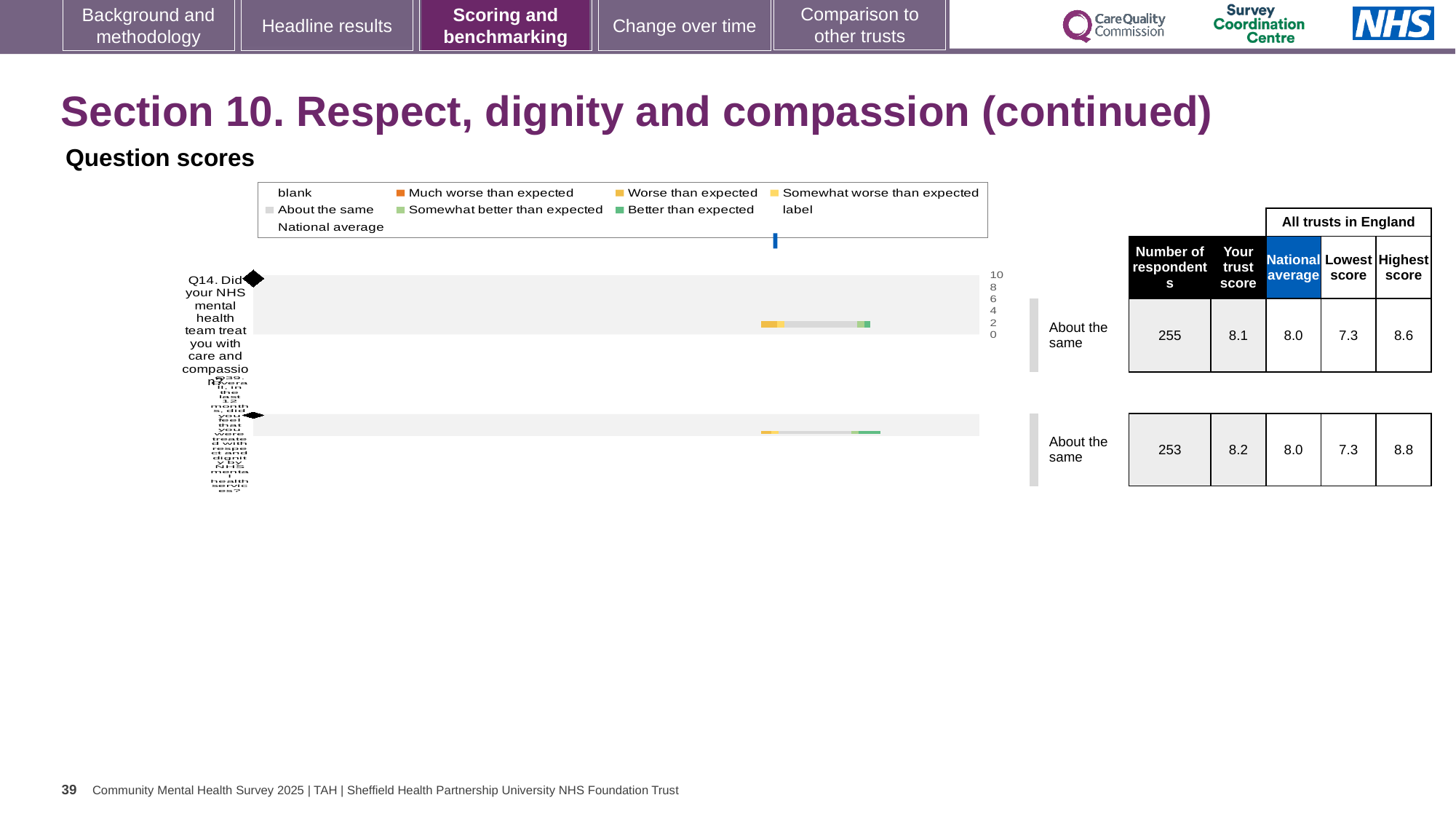
What kind of chart is used to show the question scores on this slide? bar chart What is the trust score for Q39 (respect and dignity)? 8.2 What is the highest score among all trusts in England for Q39? 8.8 What is the highest score among all trusts in England for Q14? 8.6 What benchmark category is shown for Q14 next to the chart? About the same What is the difference between the highest and lowest scores for Q14? 1.3 What is the number of respondents shown for Q14 in the table next to the chart? 255 What is the lowest score among all trusts in England for Q39? 7.3 What is the trust score for Q14 (care and compassion)? 8.1 Which question has the higher trust score, Q14 or Q39? Q39 How many questions (categories) are plotted in the question scores chart? 2 What is the national average score for Q14? 8.0